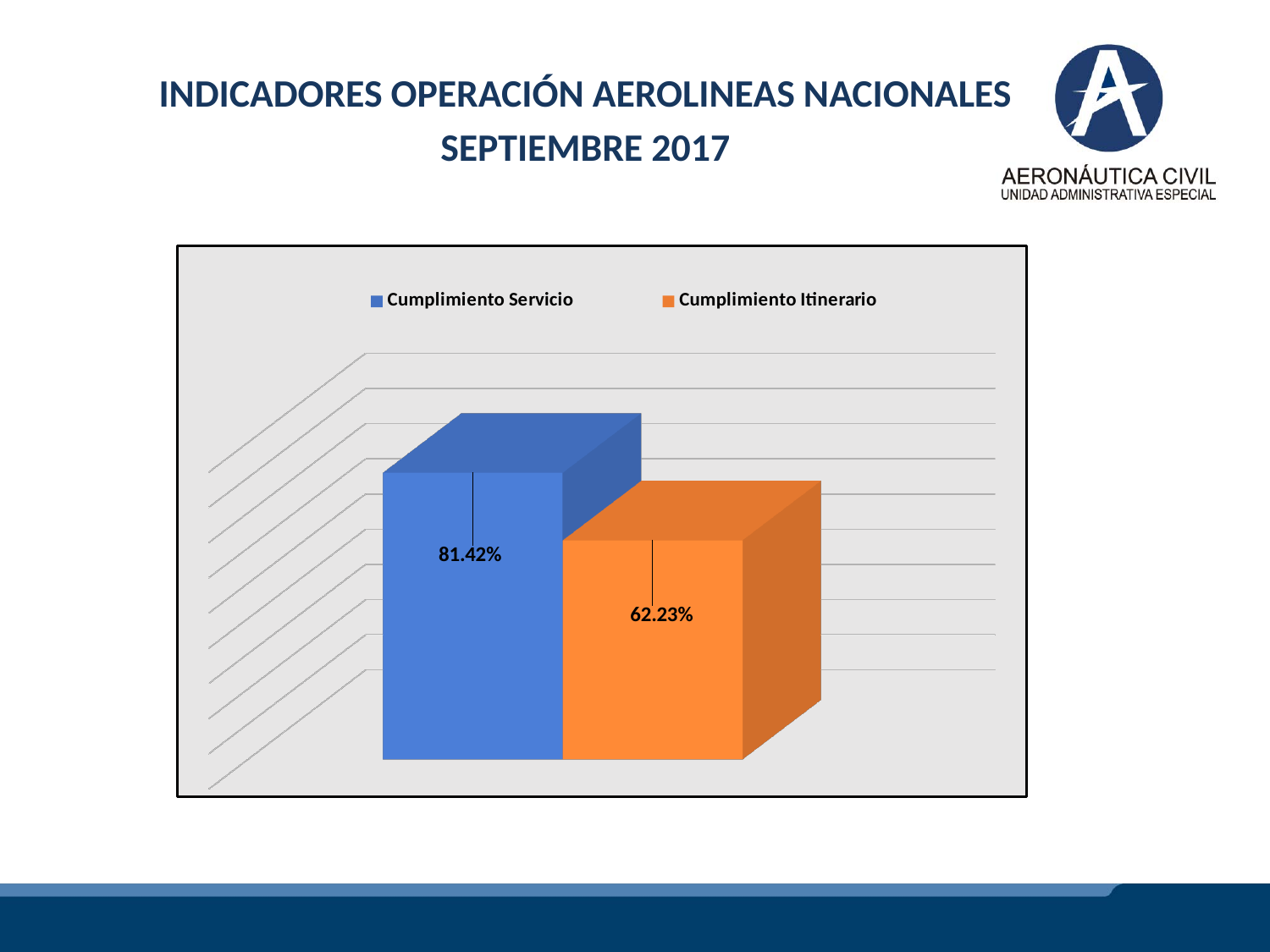
Which series has the highest value? Cumplimiento Servicio What colour is the bar for Cumplimiento Servicio? Blue Which series has the higher value, Cumplimiento Servicio or Cumplimiento Itinerario? Cumplimiento Servicio Which series has the lowest value? Cumplimiento Itinerario What colour is the bar for Cumplimiento Itinerario? Orange What is the value for Cumplimiento Itinerario? 62.23% What is the value for Cumplimiento Servicio? 81.42% How many series does the legend list? 2 How many bars are plotted in the chart? 2 What is the difference between the Cumplimiento Servicio value and the Cumplimiento Itinerario value? 19.19% What kind of chart is shown on the slide? Bar chart